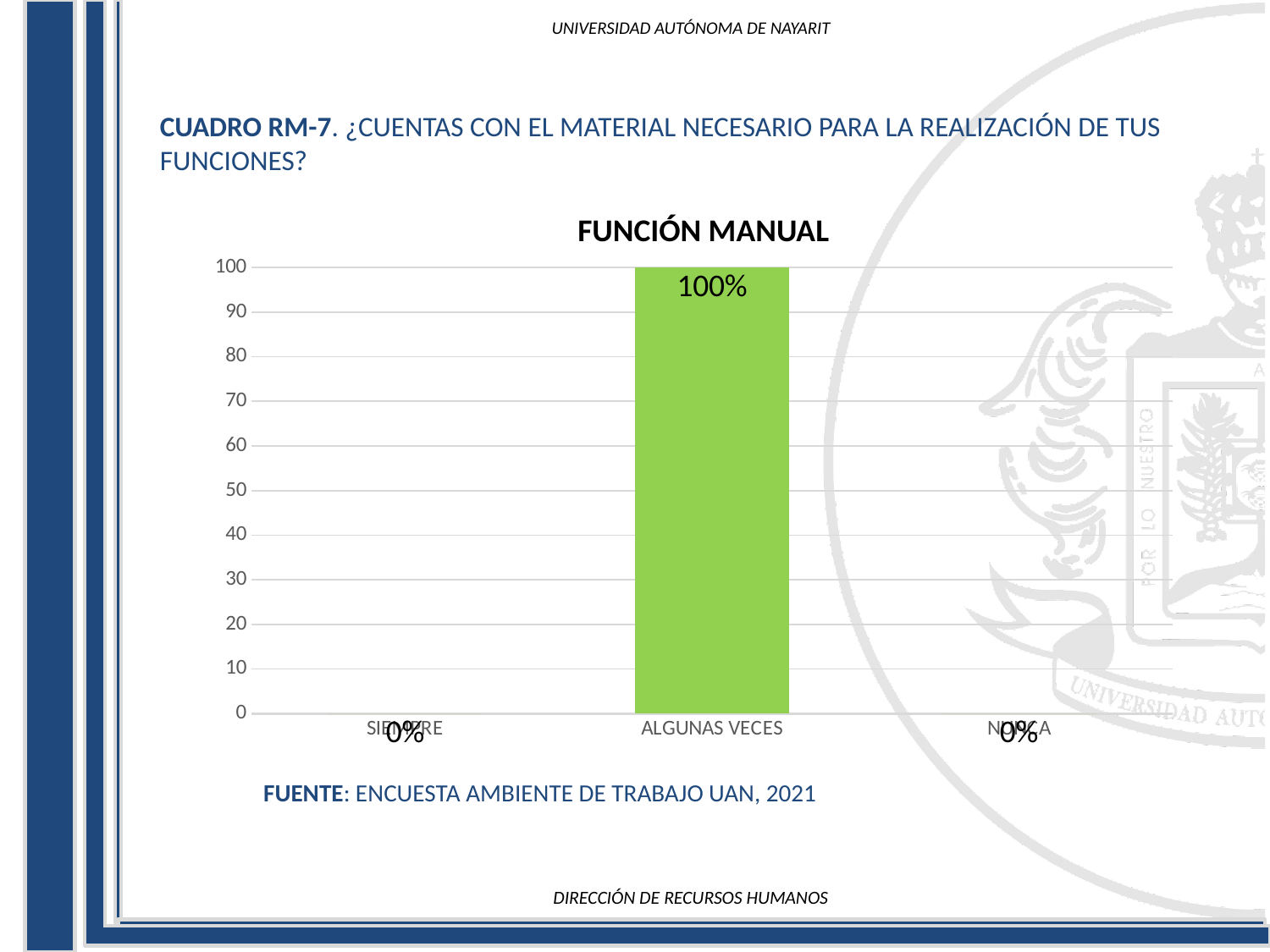
What is the difference between the values for ALGUNAS VECES and SIEMPRE? 100% How many categories are shown on the x axis? 3 Which is larger, the value for ALGUNAS VECES or the value for NUNCA? ALGUNAS VECES Is the value for ALGUNAS VECES greater or less than 50? greater What is the value for SIEMPRE? 0% What colour is the bar for ALGUNAS VECES? green What is the value for ALGUNAS VECES? 100% What is the title of the chart? FUNCIÓN MANUAL What kind of chart is shown on the slide? bar chart What is the value for NUNCA? 0% Which category has the highest value? ALGUNAS VECES What is the highest value shown on the y axis? 100